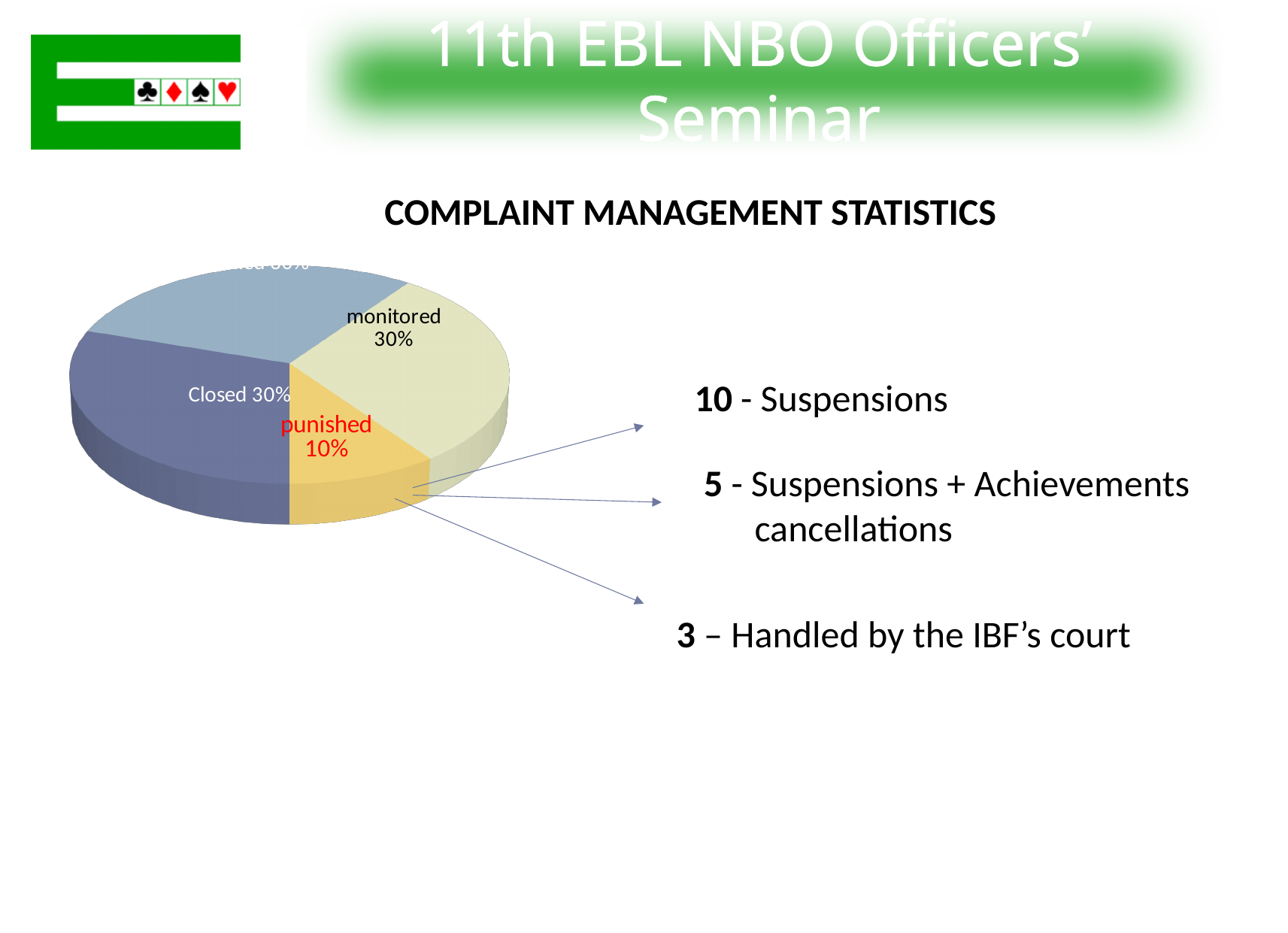
Which slice of the pie chart is the smallest? punished Do the "Closed" and "monitored" slices have the same share of the pie? Yes, both 30% How many slices does the pie chart have? 4 By how many percentage points is the "monitored" slice larger than the "punished" slice? 20 percentage points Which is larger, the "Closed" slice or the "punished" slice? Closed What percentage of the pie is labelled "Closed"? 30% Which slice label is printed in red text? punished 10% What is the heading above the pie chart? COMPLAINT MANAGEMENT STATISTICS What percentage of the pie is labelled "punished"? 10% What percentage of the pie is labelled "monitored"? 30% What kind of chart is shown on the slide? pie chart